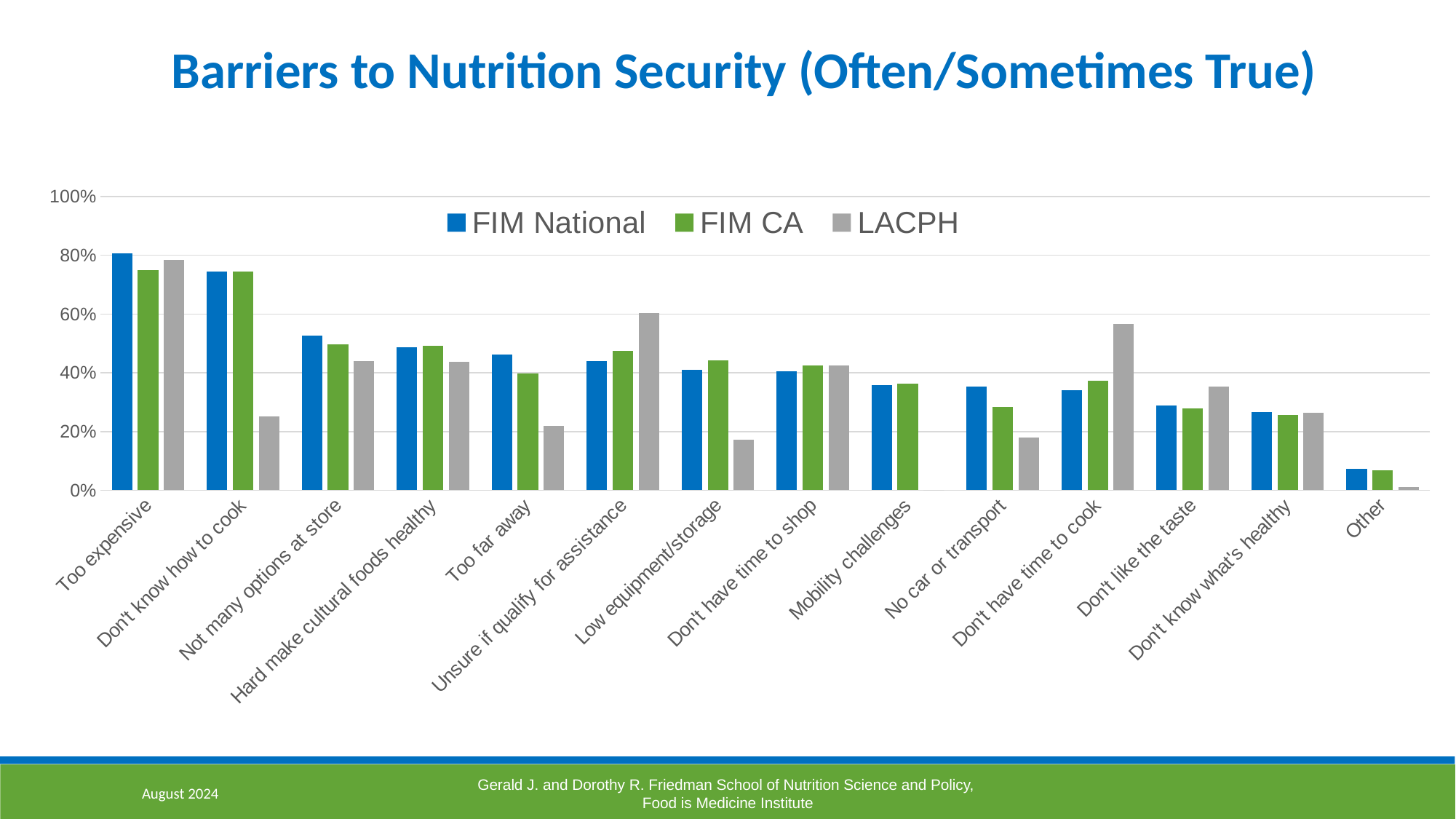
For Unsure if qualify for assistance, which series has the larger value: FIM National or LACPH? LACPH Which barrier has the lowest FIM National value? Other What kind of chart is shown on the slide? Bar chart Is the LACPH value for Low equipment/storage greater or less than 20%? less Which barrier has the highest FIM National value? Too expensive For Don't have time to cook, which series has the larger value: FIM CA or LACPH? LACPH How many series does the legend list? 3 How many barrier categories are shown along the x axis? 14 Is the LACPH value for Don't know how to cook greater or less than 40%? less Which barrier has the highest LACPH value? Too expensive Is the FIM National value for Too expensive greater or less than 60%? greater Do the FIM National values generally rise or fall from left to right across the categories? fall